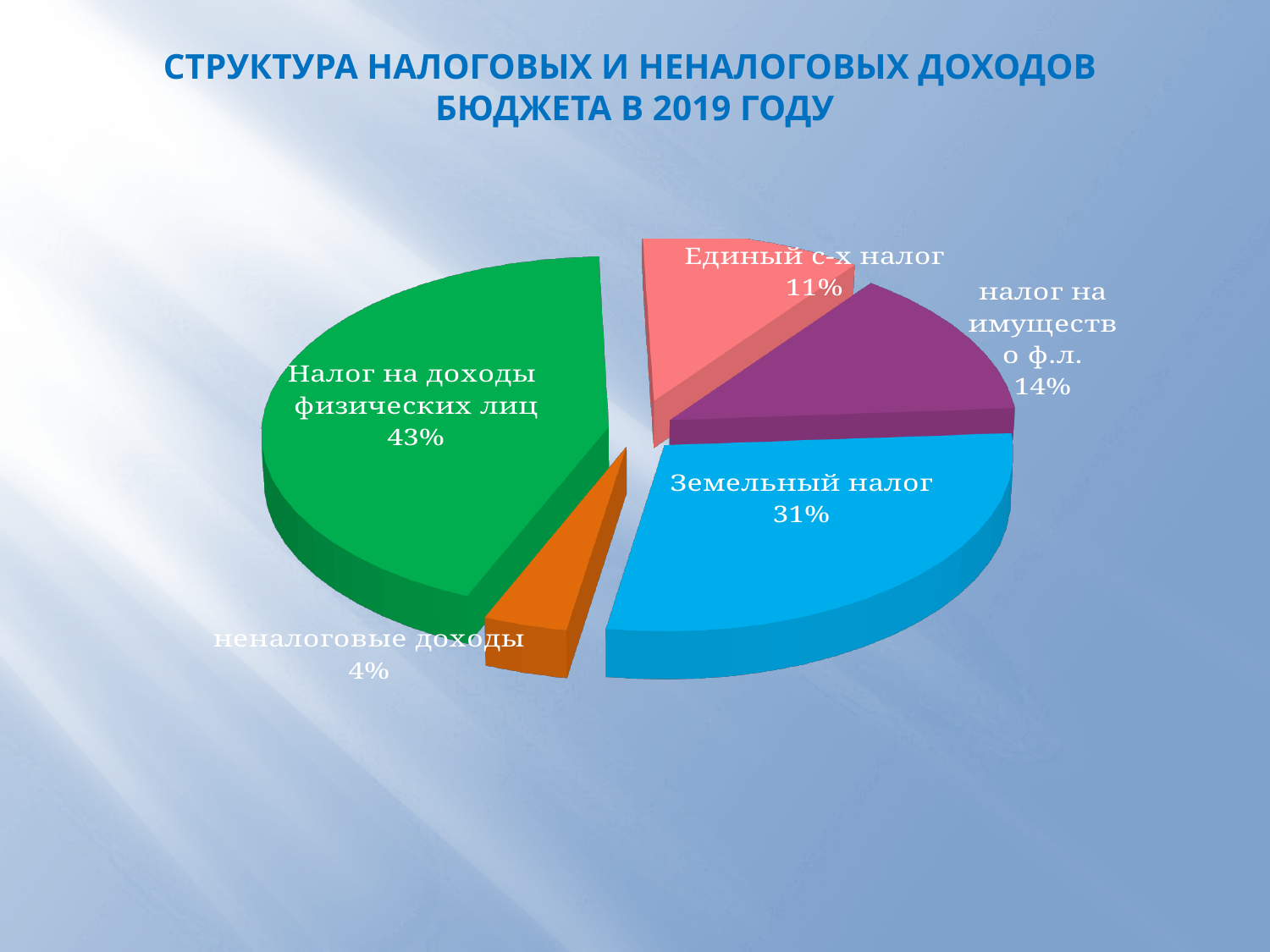
Which category has the smallest slice of the pie? неналоговые доходы How many slices does the pie chart have? 5 What share of the pie does "неналоговые доходы" have? 4% What share of the pie does "Земельный налог" have? 31% What is the title of the chart on the slide? СТРУКТУРА НАЛОГОВЫХ И НЕНАЛОГОВЫХ ДОХОДОВ БЮДЖЕТА В 2019 ГОДУ What is the difference in percentage points between "Налог на доходы физических лиц" and "Земельный налог"? 12% What share of the pie does "Единый с-х налог" have? 11% What kind of chart is shown on the slide? pie chart Which is larger: "налог на имущество ф.л." or "Единый с-х налог"? налог на имущество ф.л. Which category has the largest slice of the pie? Налог на доходы физических лиц